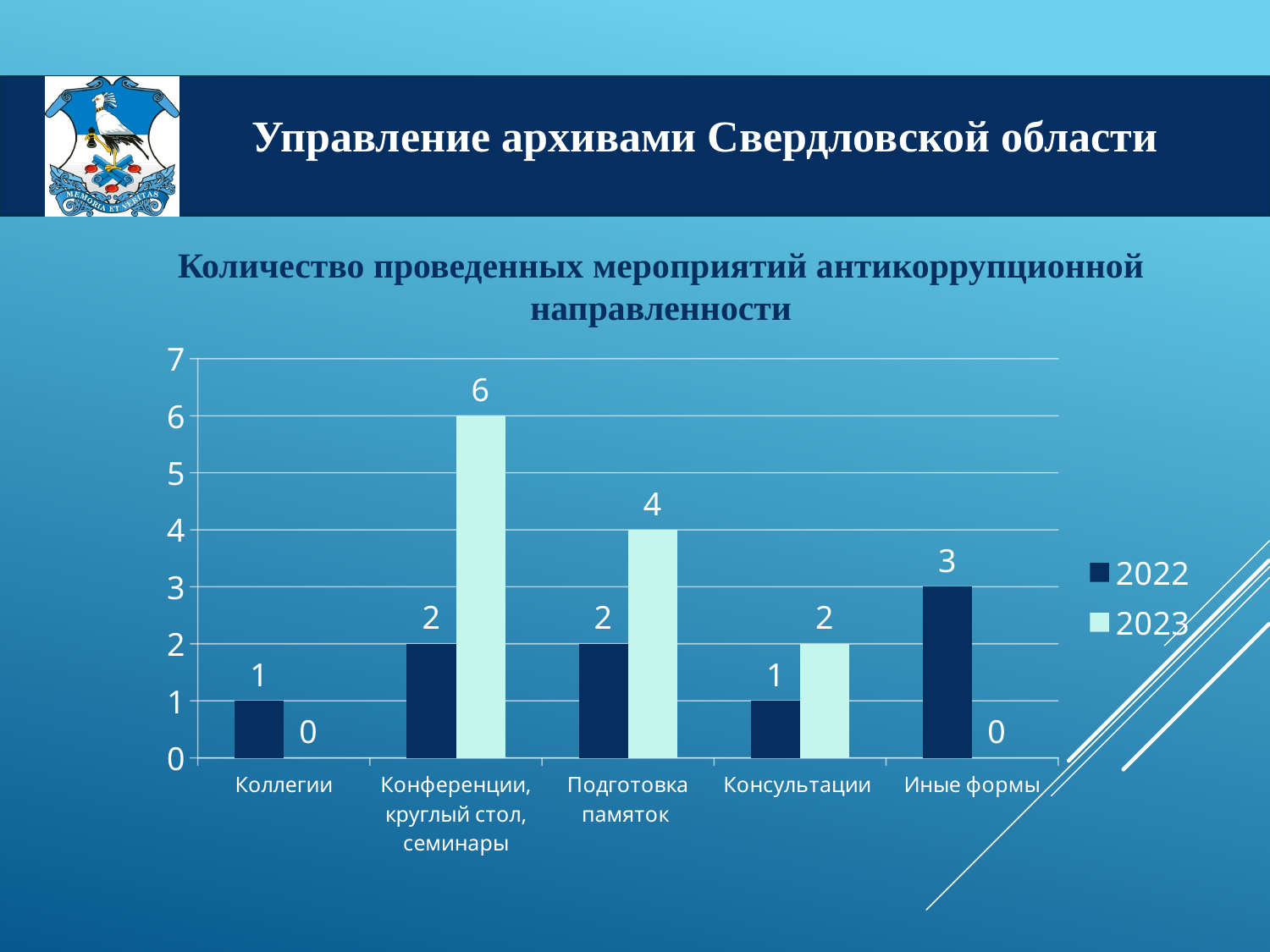
What is the difference between the 2023 value for Конференции, круглый стол, семинары and the 2023 value for Подготовка памяток? 2 Which is larger for Консультации: the 2022 value or the 2023 value? 2023 How many series does the legend list? 2 Which category has the highest 2023 value? Конференции, круглый стол, семинары What is the 2023 value for Коллегии? 0 What is the title of the chart? Количество проведенных мероприятий антикоррупционной направленности What is the 2023 value for Конференции, круглый стол, семинары? 6 Which category has the highest 2022 value? Иные формы What kind of chart is shown on the slide? bar chart What is the 2022 value for Иные формы? 3 What is the difference between the 2023 and 2022 values for Подготовка памяток? 2 How many categories are shown on the x axis? 5